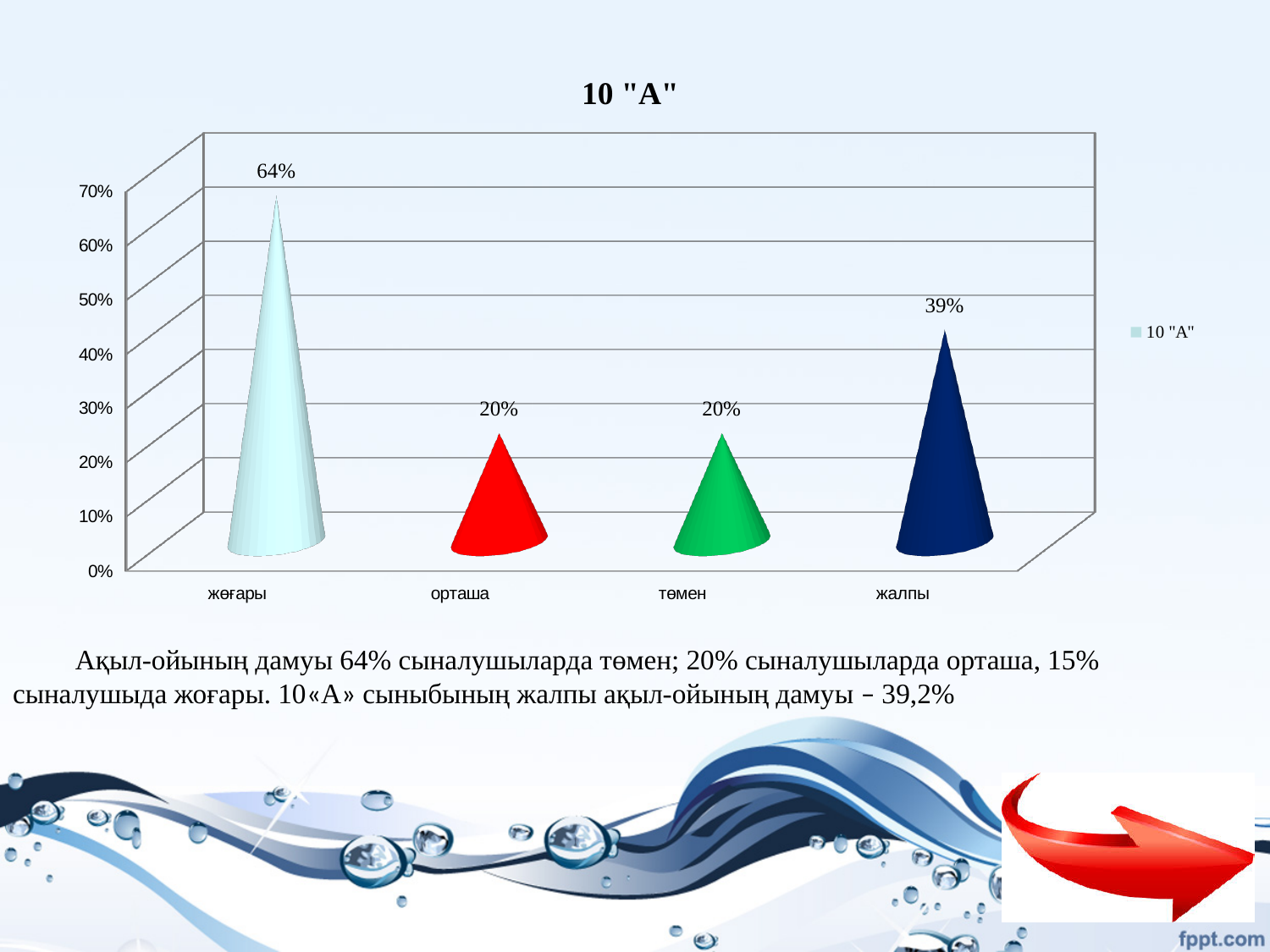
What is the value for төмен? 20% What is the difference between the values for жоғары and жалпы? 25% What is the value for орташа? 20% What is the difference between the values for жалпы and орташа? 19% Which is larger, the value for жалпы or the value for төмен? жалпы Which category has the highest value? жоғары What kind of chart is shown on the slide? bar chart What is the value for жалпы? 39% How many categories are shown on the x axis? 4 Is the value for жалпы greater or less than 30%? greater How many series does the legend list? 1 What is the value for жоғары? 64%